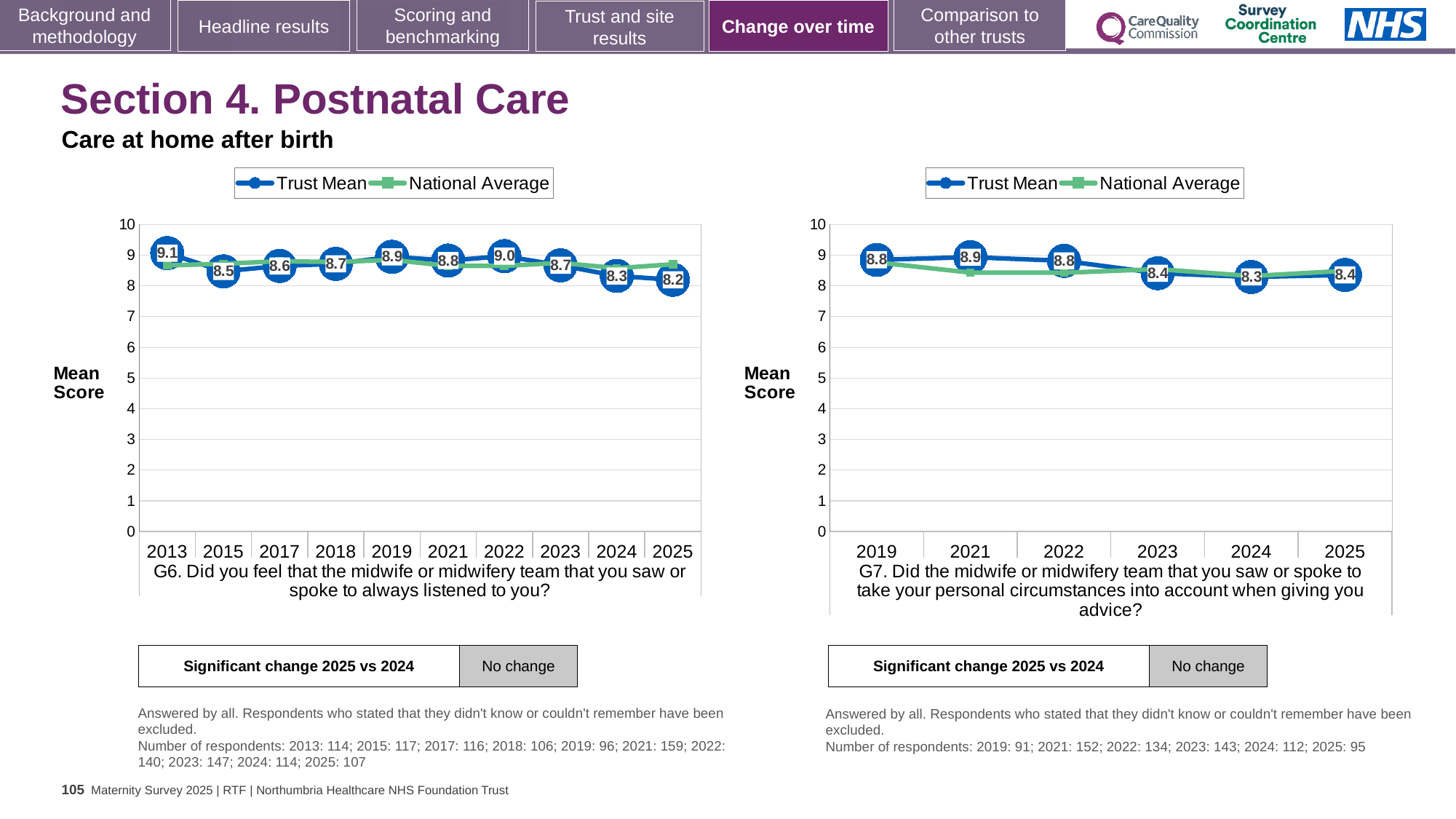
In the left chart (G6), what is the Trust Mean for 2013? 9.1 In the right chart (G7), what is the Trust Mean for 2021? 8.9 What kind of chart is the right chart (G7)? Line chart In the left chart (G6), is the National Average for 2025 greater or less than 8? greater In the right chart (G7), how many series does the legend list? 2 In the left chart (G6), which year has the lowest Trust Mean? 2025 In the left chart (G6), what is the difference between the Trust Mean in 2022 and in 2024? 0.7 In the right chart (G7), which year has the lowest Trust Mean? 2024 In the left chart (G6), which year has the highest Trust Mean? 2013 In the right chart (G7), is the Trust Mean for 2019 larger or smaller than the Trust Mean for 2023? larger In the left chart (G6), how many years are shown on the x axis? 10 In the left chart (G6), what is the Trust Mean for 2025? 8.2